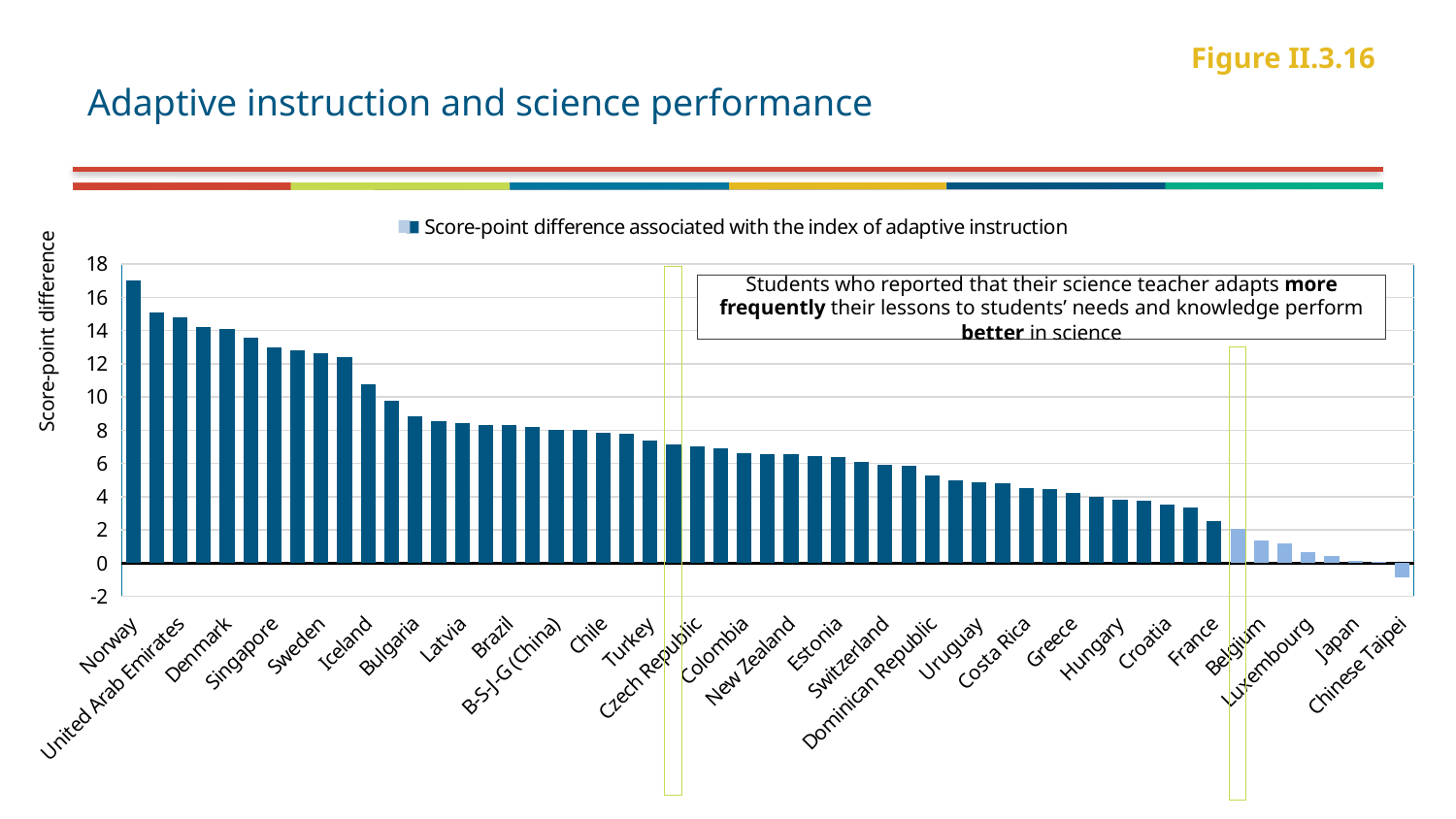
Is the value for Norway greater or less than 16? greater Is the value for Denmark greater or less than 12? greater What is the label on the vertical axis? Score-point difference Which has a larger score-point difference, Norway or Sweden? Norway What kind of chart is shown on the slide? bar chart Is the value for Chile greater or less than 10? less Which country has the highest score-point difference? Norway Which country has the lowest score-point difference? Chinese Taipei Do the values rise or fall moving from left to right along the x axis? fall